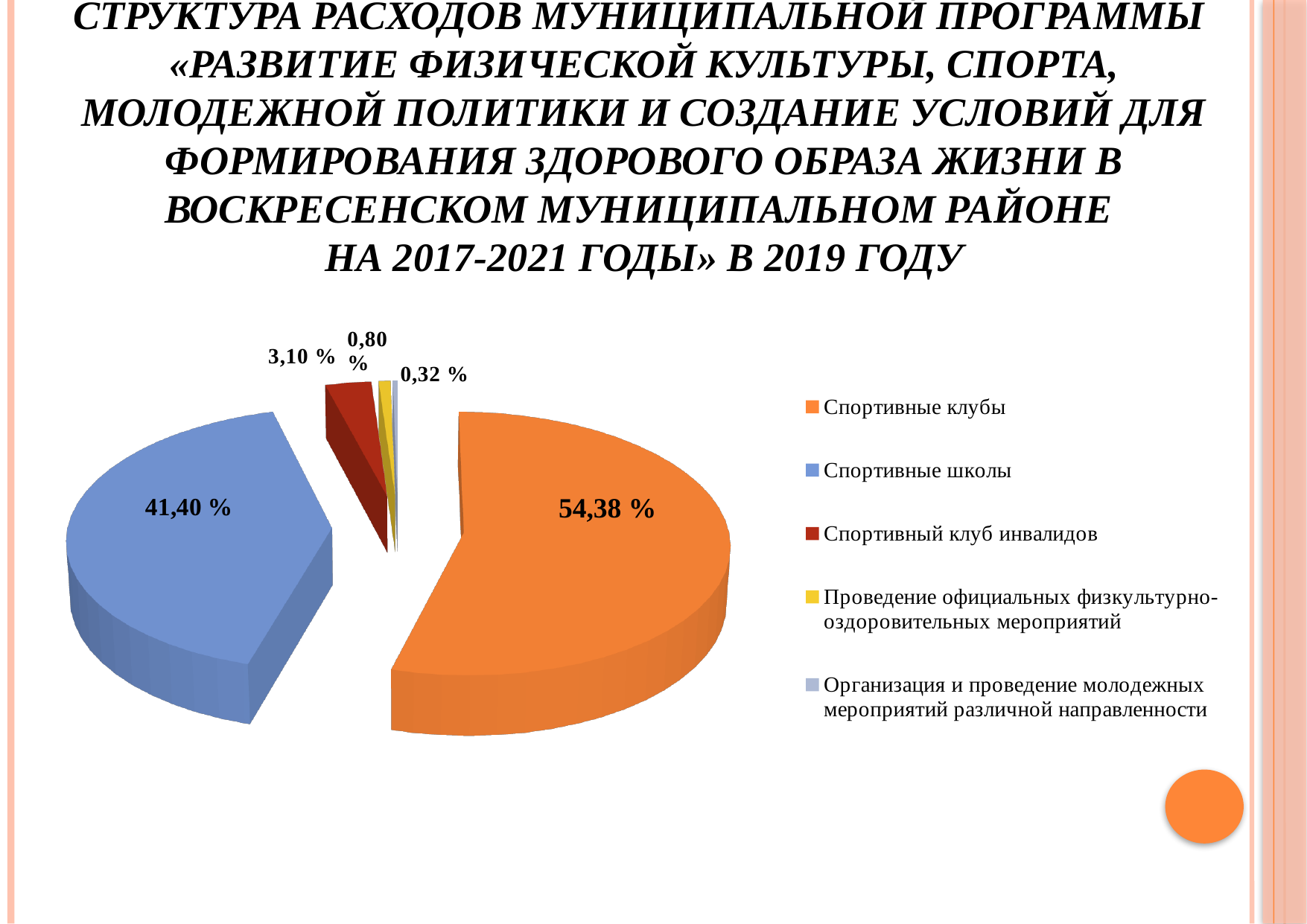
What share of expenditure goes to Спортивные школы? 41,40 % How many categories does the pie chart show? 5 What colour is the slice for Спортивные школы? blue Which category has the largest share of expenditure? Спортивные клубы What share of expenditure goes to Спортивные клубы? 54,38 % What share of expenditure goes to Организация и проведение молодежных мероприятий различной направленности? 0,32 % What type of chart is shown on the slide? pie chart What is the difference in percentage points between the shares of Спортивные клубы and Спортивные школы? 12,98 Which has a larger share: Спортивный клуб инвалидов or Проведение официальных физкультурно-оздоровительных мероприятий? Спортивный клуб инвалидов What share of expenditure goes to Проведение официальных физкультурно-оздоровительных мероприятий? 0,80 % Which category has the smallest share of expenditure? Организация и проведение молодежных мероприятий различной направленности What share of expenditure goes to Спортивный клуб инвалидов? 3,10 %